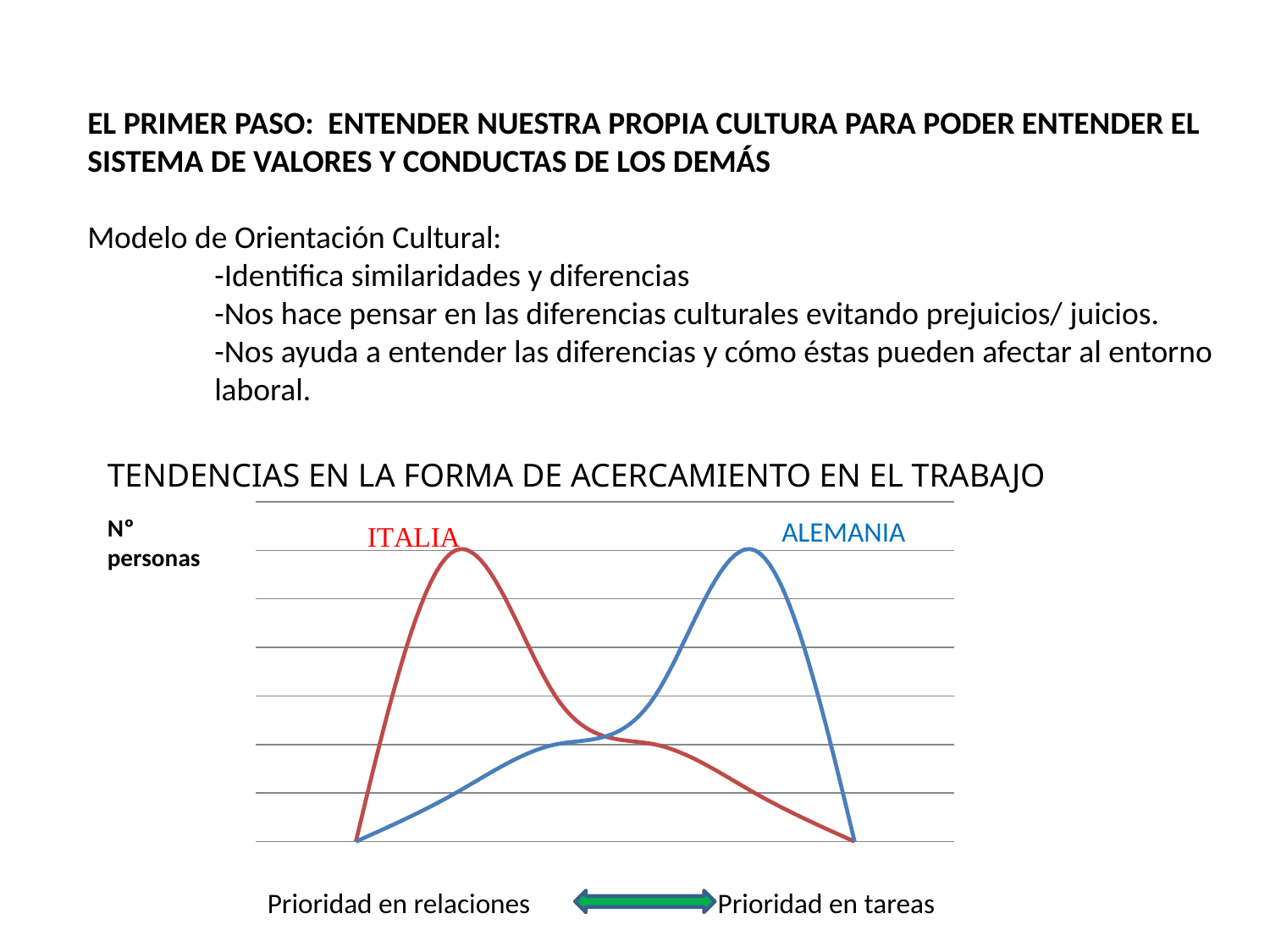
What kind of chart is shown on the slide? Line chart Which series peaks closer to the 'Prioridad en tareas' end of the x axis, ITALIA or ALEMANIA? ALEMANIA Which series peaks closer to the 'Prioridad en relaciones' end of the x axis, ITALIA or ALEMANIA? ITALIA Which series is plotted in blue? ALEMANIA Which colour is used for the ITALIA curve? Red Moving from left to right along the x axis, does the ALEMANIA curve rise or fall before reaching its peak? Rise Moving from left to right along the x axis, does the ITALIA curve rise or fall after its peak? Fall How many series (curves) are plotted on the chart? 2 What is the title of the chart? TENDENCIAS EN LA FORMA DE ACERCAMIENTO EN EL TRABAJO